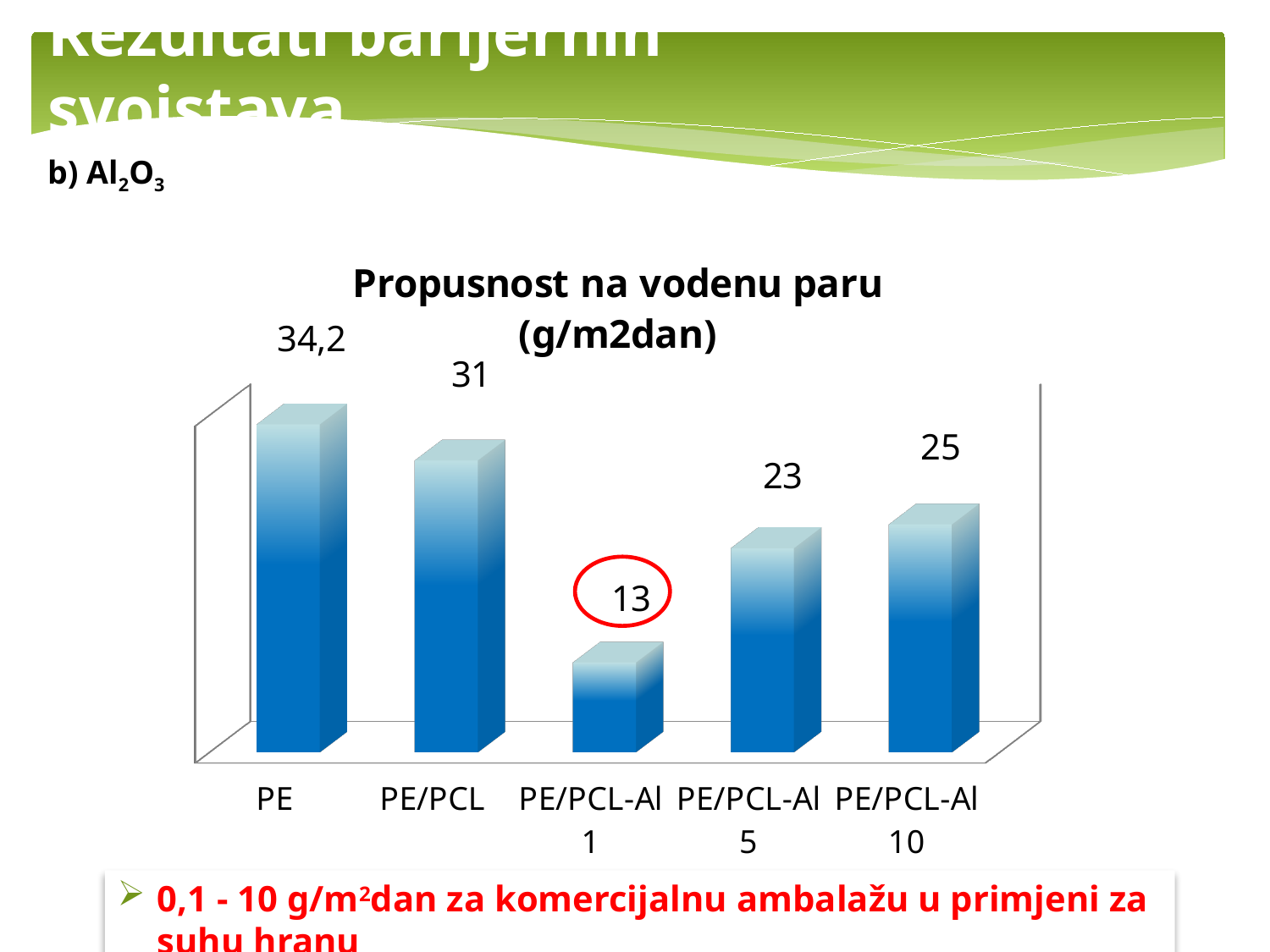
What is the value for PE/PCL-Al 10 in the chart? 25 What is the title of the chart? Propusnost na vodenu paru (g/m2dan) Which category has the highest value in the chart? PE How many categories are shown in the chart? 5 What is the value for PE/PCL in the chart? 31 What is the value for PE/PCL-Al 1 in the chart? 13 Which has a larger value, PE/PCL-Al 5 or PE/PCL-Al 10? PE/PCL-Al 10 What is the difference between the values for PE/PCL and PE/PCL-Al 1? 18 Which category has the lowest value in the chart? PE/PCL-Al 1 What kind of chart is shown on the slide? Bar chart What is the value for PE/PCL-Al 5 in the chart? 23 What is the value for PE in the chart? 34,2